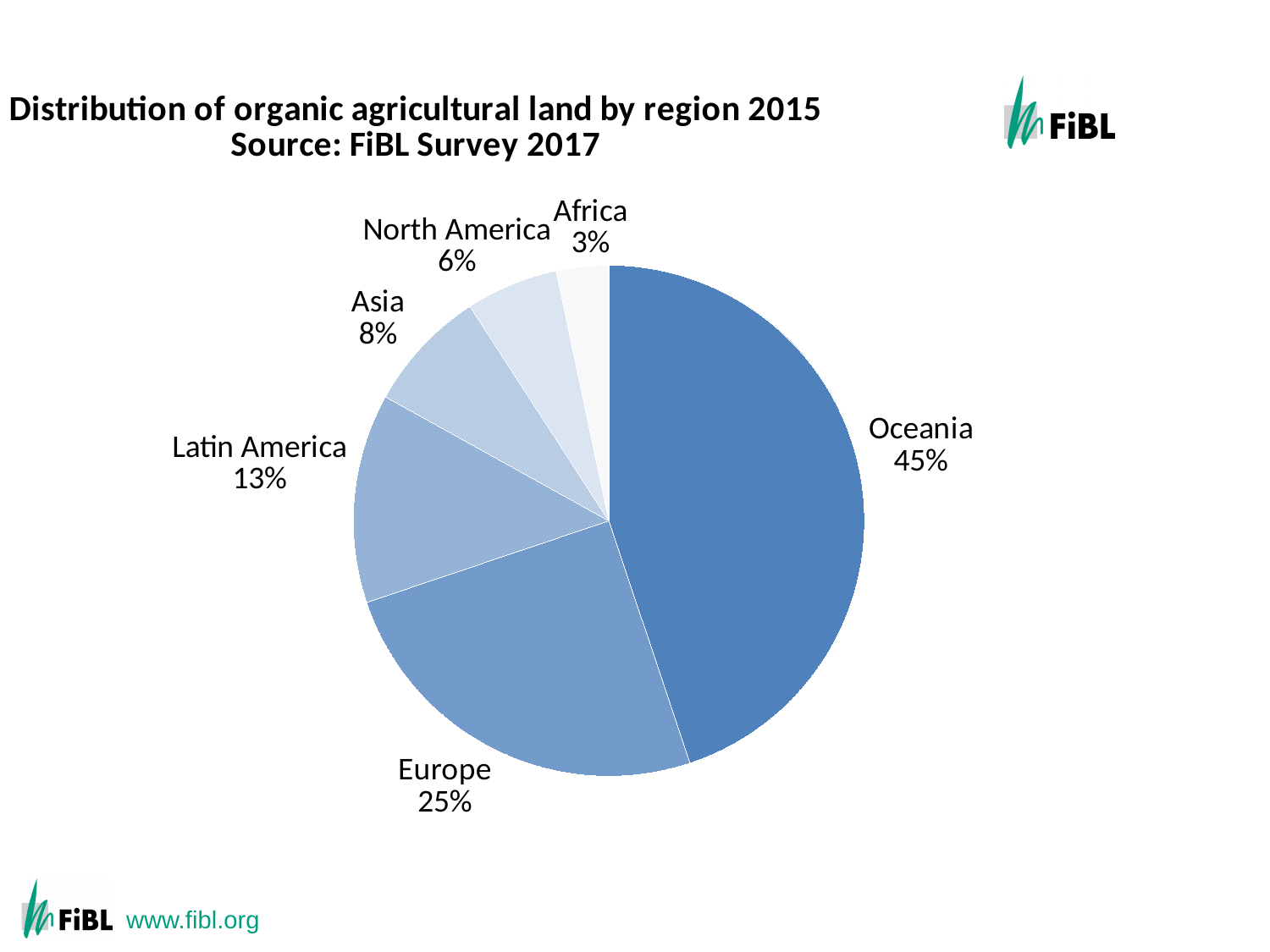
Which region has the largest share of organic agricultural land? Oceania How many percentage points larger is Oceania's share than Europe's share? 20 Which region has a larger share, Latin America or Asia? Latin America What kind of chart is shown on the slide? Pie chart Which region has the smallest share of organic agricultural land? Africa How many regions are shown in the pie chart? 6 What is the title of the chart? Distribution of organic agricultural land by region 2015 What share of organic agricultural land does Latin America hold? 13% What share of organic agricultural land does Oceania hold? 45% What share of organic agricultural land does Europe hold? 25% What share of organic agricultural land does North America hold? 6% What share of organic agricultural land does Asia hold? 8%